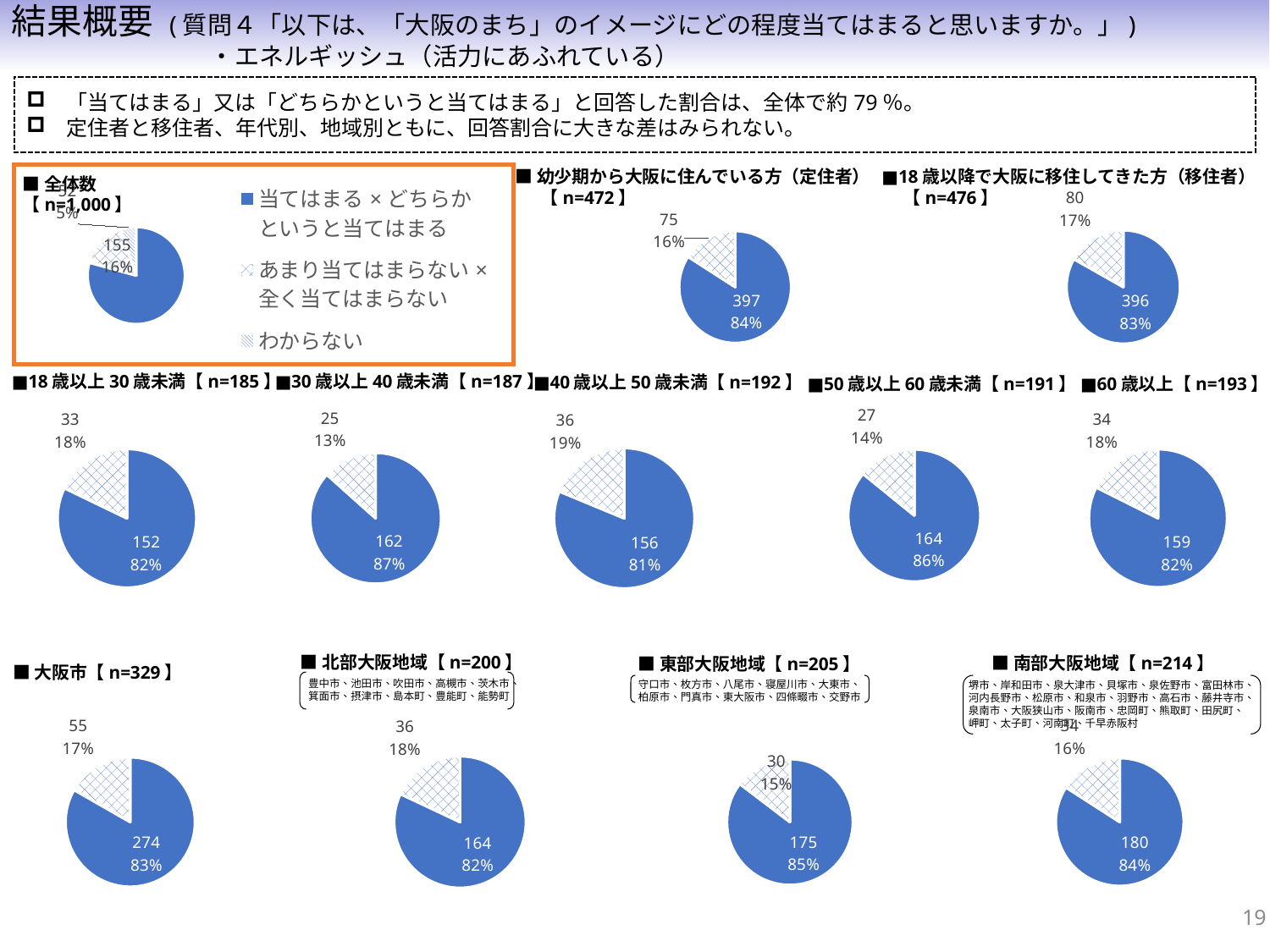
Which has a larger blue-slice percentage: the 北部大阪地域 chart or the 東部大阪地域 chart? 東部大阪地域 Among the five age-group charts, which group has the lowest blue-slice percentage? 40 歳以上 50 歳未満 In the chart for 大阪市, what percentage is shown for the hatched slice? 17% In the chart for 幼少期から大阪に住んでいる方（定住者）, what percentage is shown for the blue slice (当てはまる × どちらかというと当てはまる)? 84% In the chart for 30 歳以上 40 歳未満, what percentage is shown for the blue slice? 87% What type of chart is used throughout this slide? Pie chart Among the five age-group charts (18 歳以上 30 歳未満 through 60 歳以上), which group has the highest blue-slice percentage? 30 歳以上 40 歳未満 How many entries does the legend in the 全体数 box list? 3 What is the difference in blue-slice respondent counts between the 定住者 chart (397) and the 移住者 chart (396)? 1 In the chart for 東部大阪地域, how many respondents are in the blue slice? 175 In the chart for 18 歳以降で大阪に移住してきた方（移住者）, how many respondents are in the blue slice? 396 In the chart for 40 歳以上 50 歳未満, how many respondents are in the hatched slice (あまり当てはまらない × 全く当てはまらない)? 36